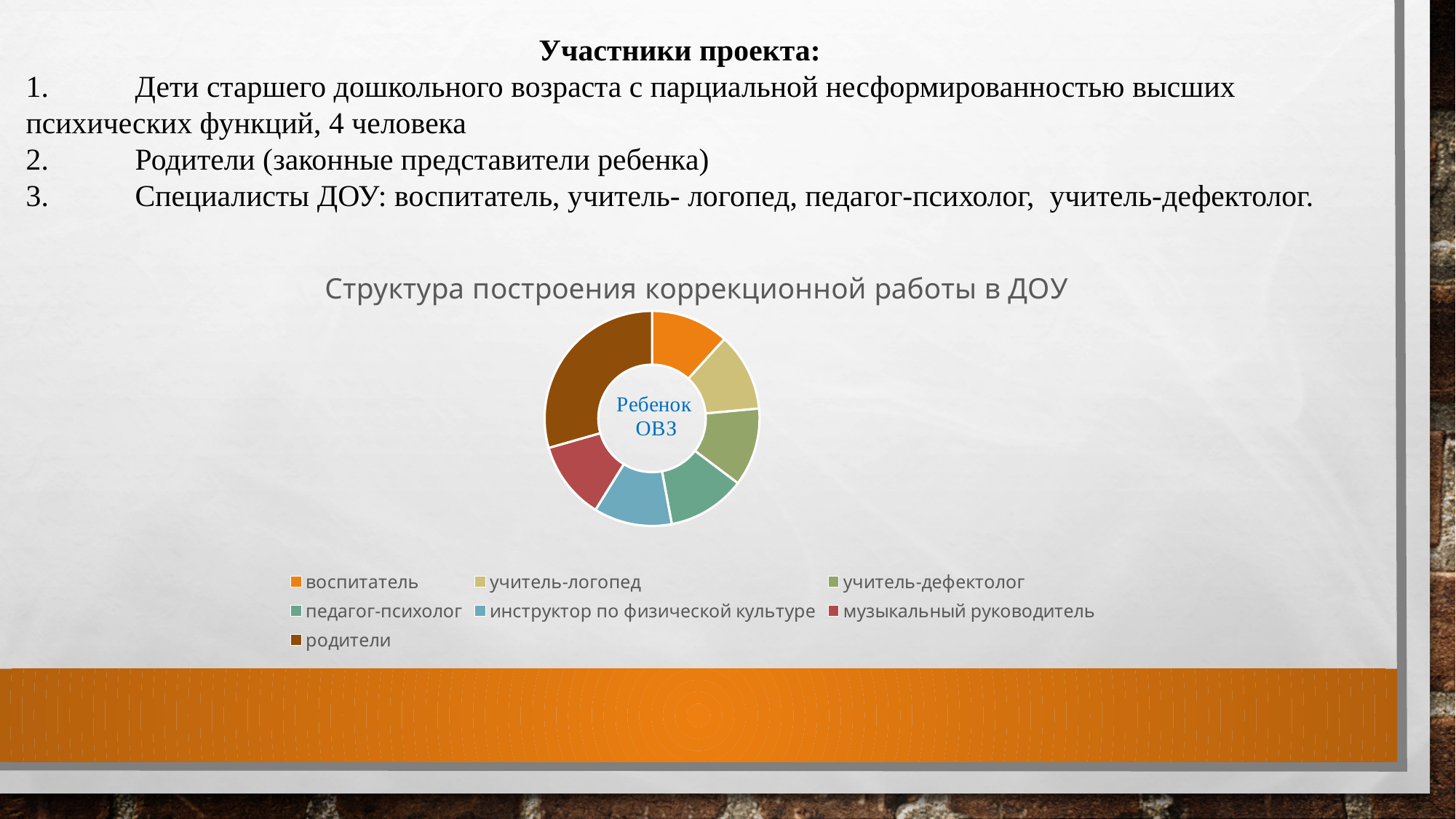
Which slice is larger: родители or воспитатель? родители How many categories does the chart show? 7 Which category has the largest slice in the chart? родители Which slice is larger: родители or инструктор по физической культуре? родители What is the title of the chart? Структура построения коррекционной работы в ДОУ What kind of chart is shown on the slide? Doughnut (pie) chart Which slice is larger: родители or музыкальный руководитель? родители What text is written in the centre of the doughnut chart? Ребенок ОВЗ